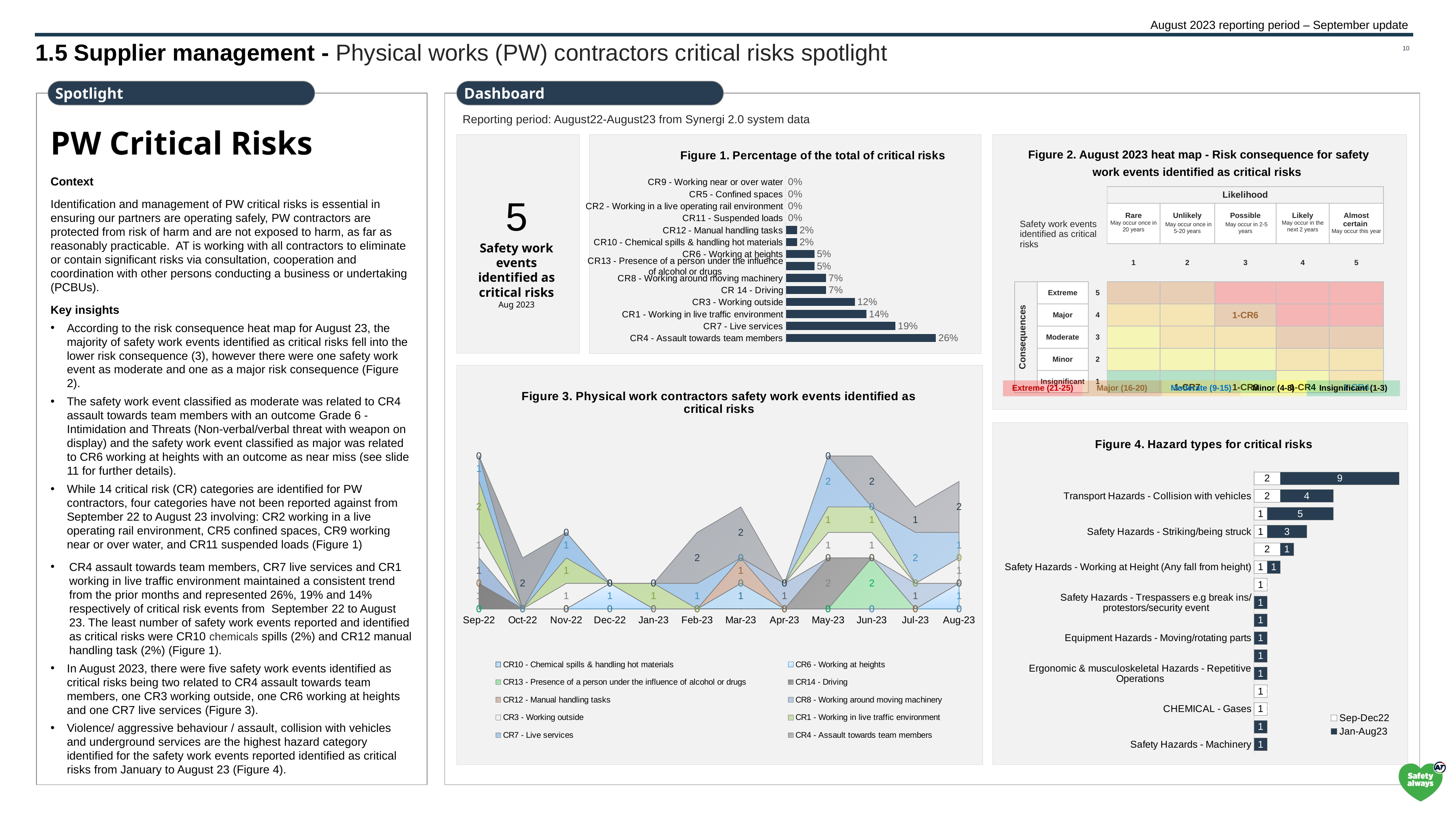
In Figure 1, what percentage is shown for CR1 - Working in live traffic environment? 14% In Figure 1, which critical risk category has the highest percentage? CR4 - Assault towards team members How many months are shown on the x axis of Figure 3? 12 How many series does the legend of Figure 4 list? 2 In Figure 1, what percentage is shown for CR7 - Live services? 19% In Figure 1, what is the difference in percentage points between CR4 - Assault towards team members and CR7 - Live services? 7% In Figure 1, what percentage is shown for CR4 - Assault towards team members? 26% In Figure 4, what is the Jan-Aug23 value for Safety Hazards - Striking/being struck? 3 How many critical risk categories are listed in Figure 1? 14 In Figure 4, what is the Jan-Aug23 value for Transport Hazards - Collision with vehicles? 4 In Figure 1, which is larger: the percentage for CR3 - Working outside or for CR8 - Working around moving machinery? CR3 - Working outside What kind of chart is Figure 1? Bar chart